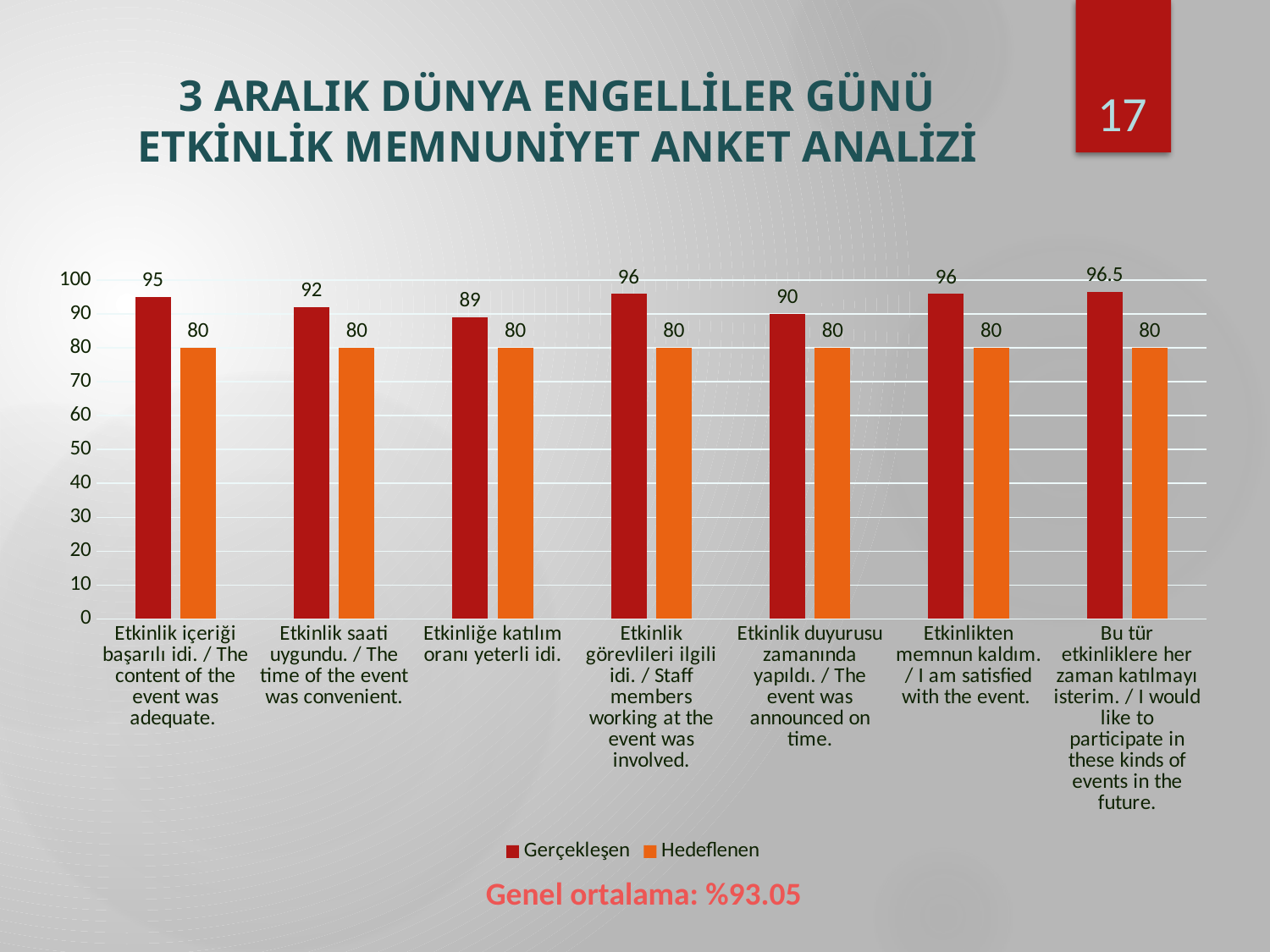
Which category has the lowest Gerçekleşen value? Etkinliğe katılım oranı yeterli idi. What is the difference between the Gerçekleşen and Hedeflenen values for "Etkinlik duyurusu zamanında yapıldı. / The event was announced on time."? 10 Which is larger for "Etkinlik saati uygundu. / The time of the event was convenient.": the Gerçekleşen value or the Hedeflenen value? Gerçekleşen Is the Gerçekleşen value for "Etkinlikten memnun kaldım. / I am satisfied with the event." greater or less than 90? greater What kind of chart is shown on the slide? Bar chart What is the Hedeflenen value for "Etkinlik saati uygundu. / The time of the event was convenient."? 80 What is the Gerçekleşen value for "Etkinlik içeriği başarılı idi. / The content of the event was adequate."? 95 How many series does the legend list? 2 What is the Gerçekleşen value for "Etkinliğe katılım oranı yeterli idi."? 89 Which category has the highest Gerçekleşen value? Bu tür etkinliklere her zaman katılmayı isterim. / I would like to participate in these kinds of events in the future. What overall average (Genel ortalama) is stated below the chart? %93.05 How many categories are shown on the x axis? 7